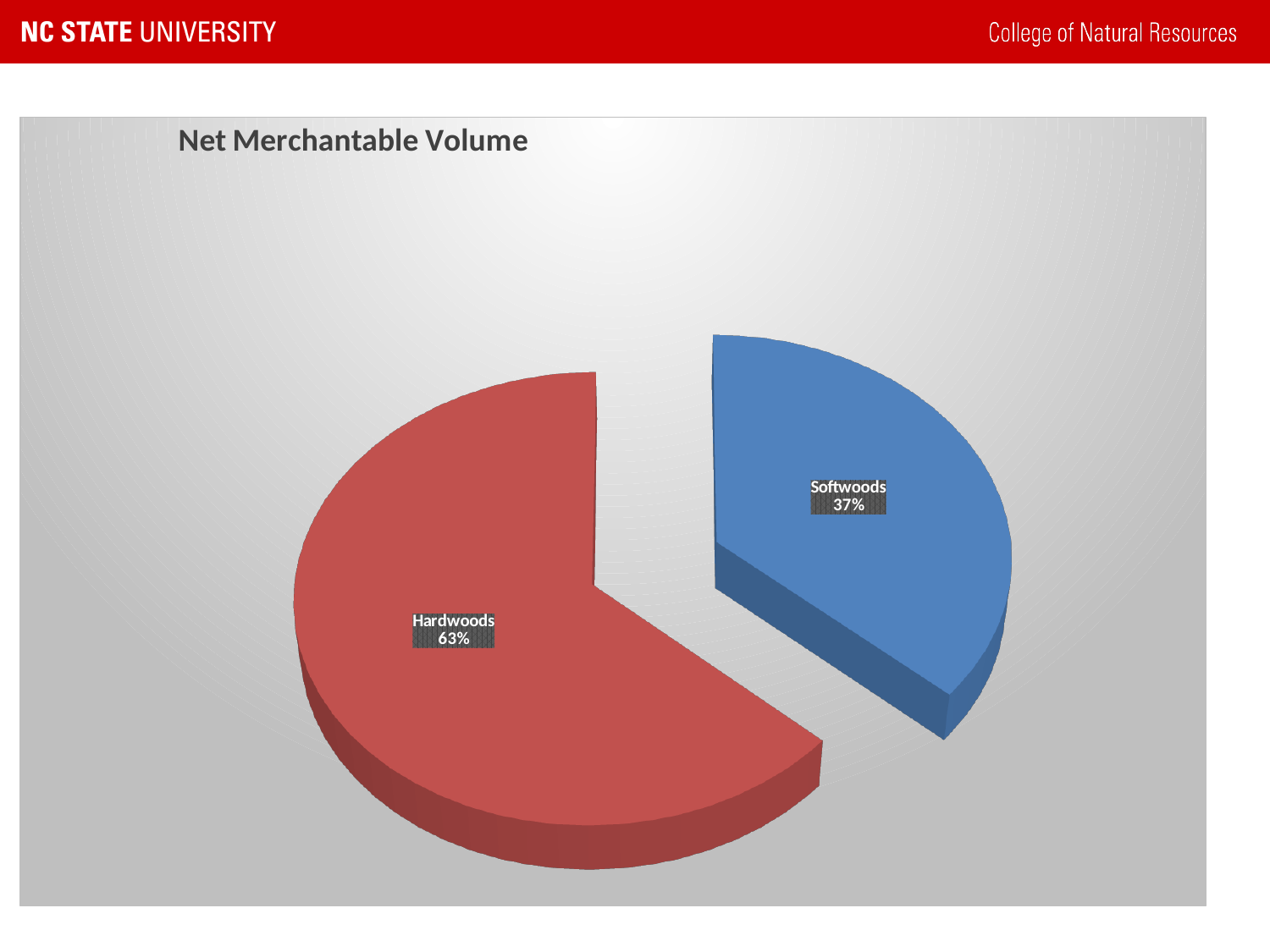
What share of Net Merchantable Volume is Hardwoods? 63% What share of Net Merchantable Volume is Softwoods? 37% Which category has the largest share of Net Merchantable Volume? Hardwoods What is the difference in percentage points between the Hardwoods and Softwoods shares? 26 percentage points Which category has the smallest share of Net Merchantable Volume? Softwoods Which is larger, the Hardwoods share or the Softwoods share? Hardwoods What kind of chart is shown on the slide? Pie chart Is the Hardwoods share greater or less than 50%? greater What colour is the Softwoods slice? Blue Is the Softwoods share greater or less than 50%? less How many slices does the pie chart have? 2 What is the title of the chart? Net Merchantable Volume